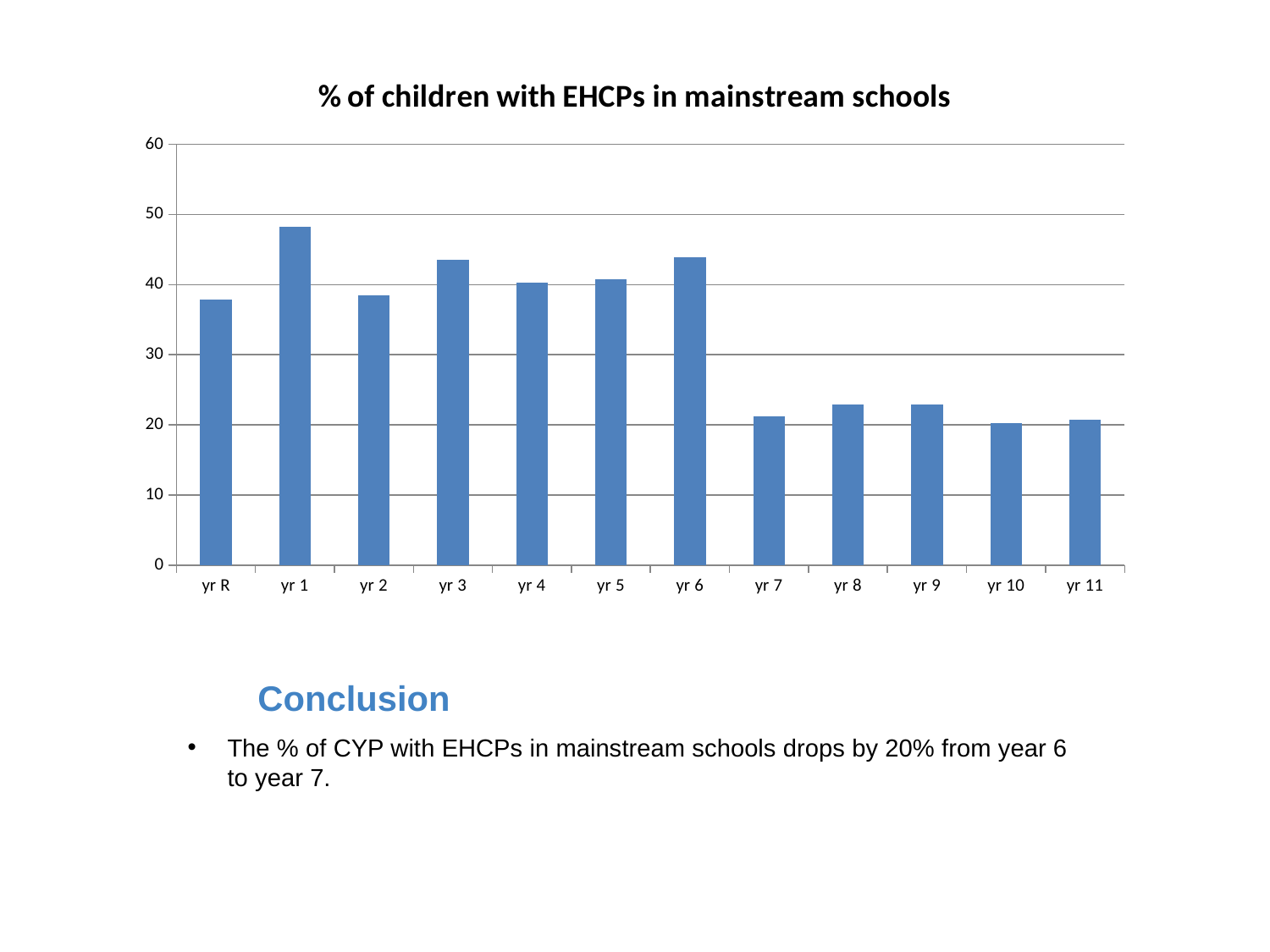
Which year group has the highest % of children with EHCPs in mainstream schools? yr 1 How many year groups are shown on the x axis of the chart? 12 Which is larger, the value for yr 6 or the value for yr 7? yr 6 Is the value for yr 8 greater or less than 30? less Does the value rise or fall from yr 6 to yr 7? fall What type of chart is shown on the slide? Bar chart Is the value for yr 3 greater or less than 40? greater Is the value for yr R greater or less than 40? less What is the title of the chart? % of children with EHCPs in mainstream schools What is the highest value shown on the vertical axis of the chart? 60 Which is larger, the value for yr 2 or the value for yr 3? yr 3